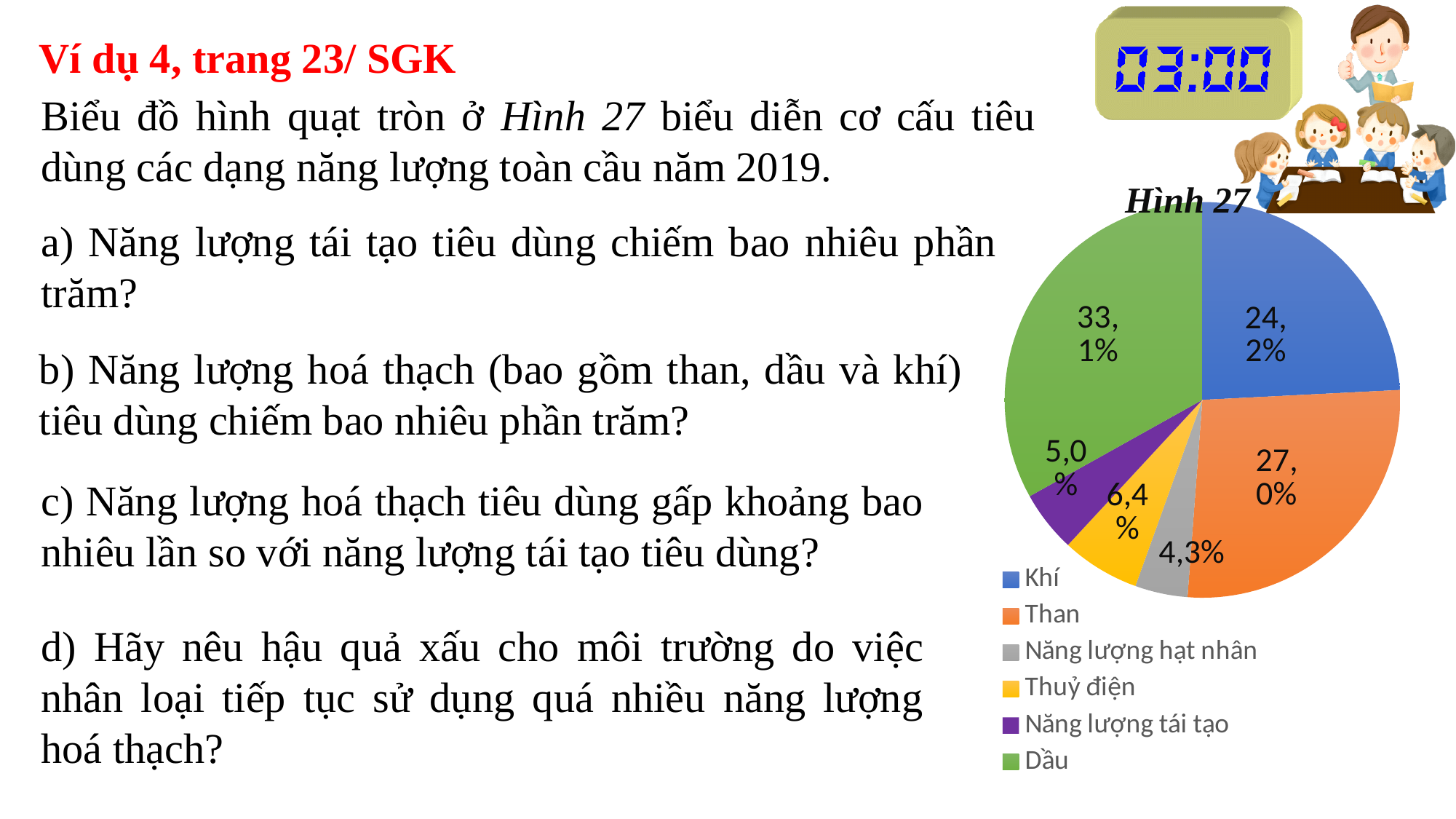
What is the difference between the Dầu slice and the Than slice? 6,1% What percentage does the Thuỷ điện slice represent? 6,4% What percentage does the Năng lượng tái tạo slice represent? 5,0% What percentage does the Dầu slice represent? 33,1% What percentage does the Khí slice represent? 24,2% What percentage does the Than slice represent? 27,0% What kind of chart is shown on the slide? pie chart Which is larger, the Than slice or the Khí slice? Than Which category has the smallest slice of the pie? Năng lượng hạt nhân What colour is the Thuỷ điện slice? yellow Which category has the largest slice of the pie? Dầu How many categories does the legend list? 6